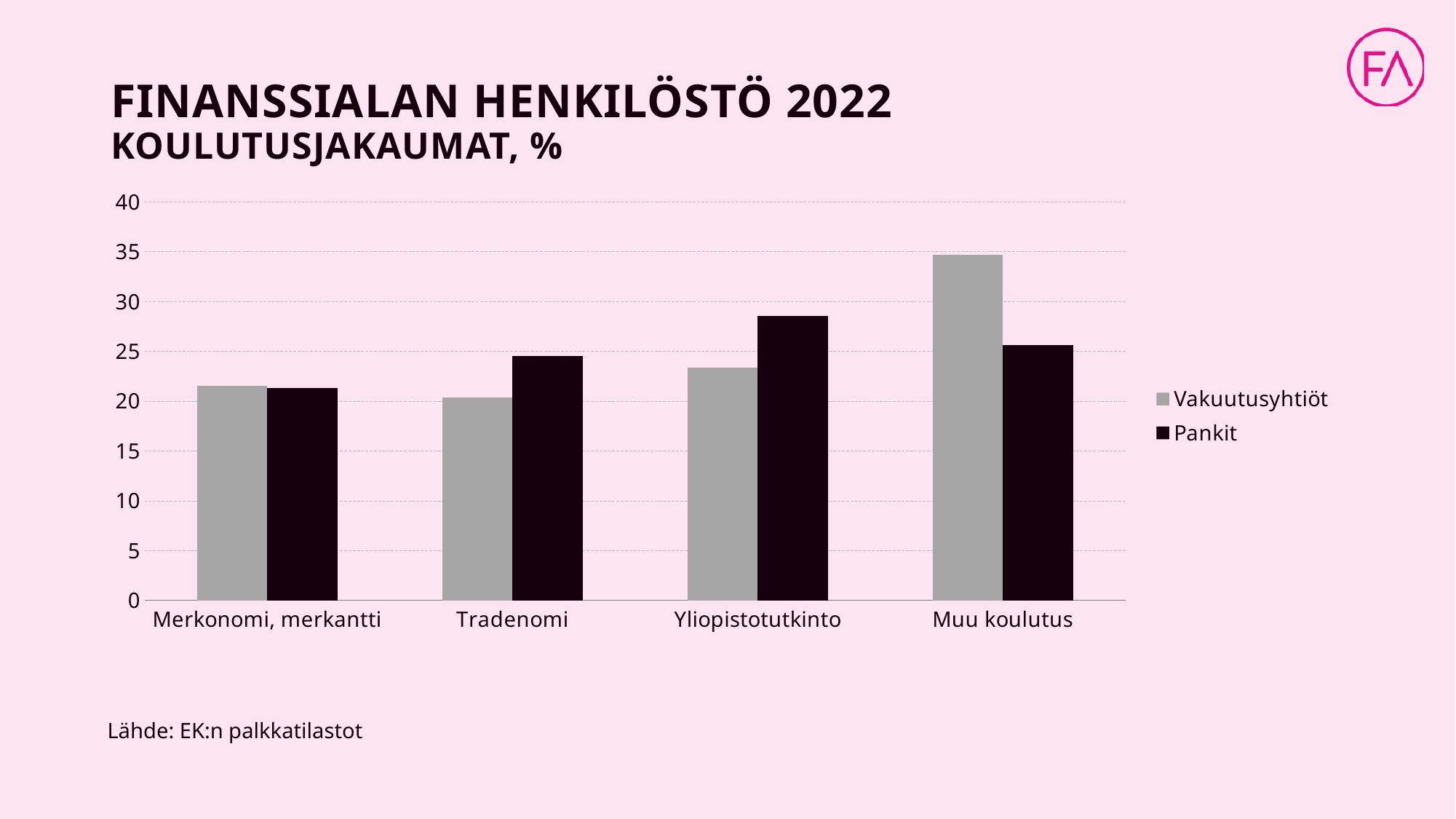
Is the value for Vakuutusyhtiöt in Muu koulutus greater or less than 30? greater What kind of chart is shown on the slide? bar chart For Yliopistotutkinto, which series has the larger value, Vakuutusyhtiöt or Pankit? Pankit Which category has the lowest value for Pankit? Merkonomi, merkantti What is the subtitle of the chart below the main title? KOULUTUSJAKAUMAT, % Which category has the highest value for Pankit? Yliopistotutkinto How many series does the legend list? 2 Is the value for Pankit in Yliopistotutkinto greater or less than 25? greater For Muu koulutus, which series has the larger value, Vakuutusyhtiöt or Pankit? Vakuutusyhtiöt Is the value for Vakuutusyhtiöt in Yliopistotutkinto greater or less than 25? less How many education categories are shown on the x axis? 4 Which category has the highest value for Vakuutusyhtiöt? Muu koulutus